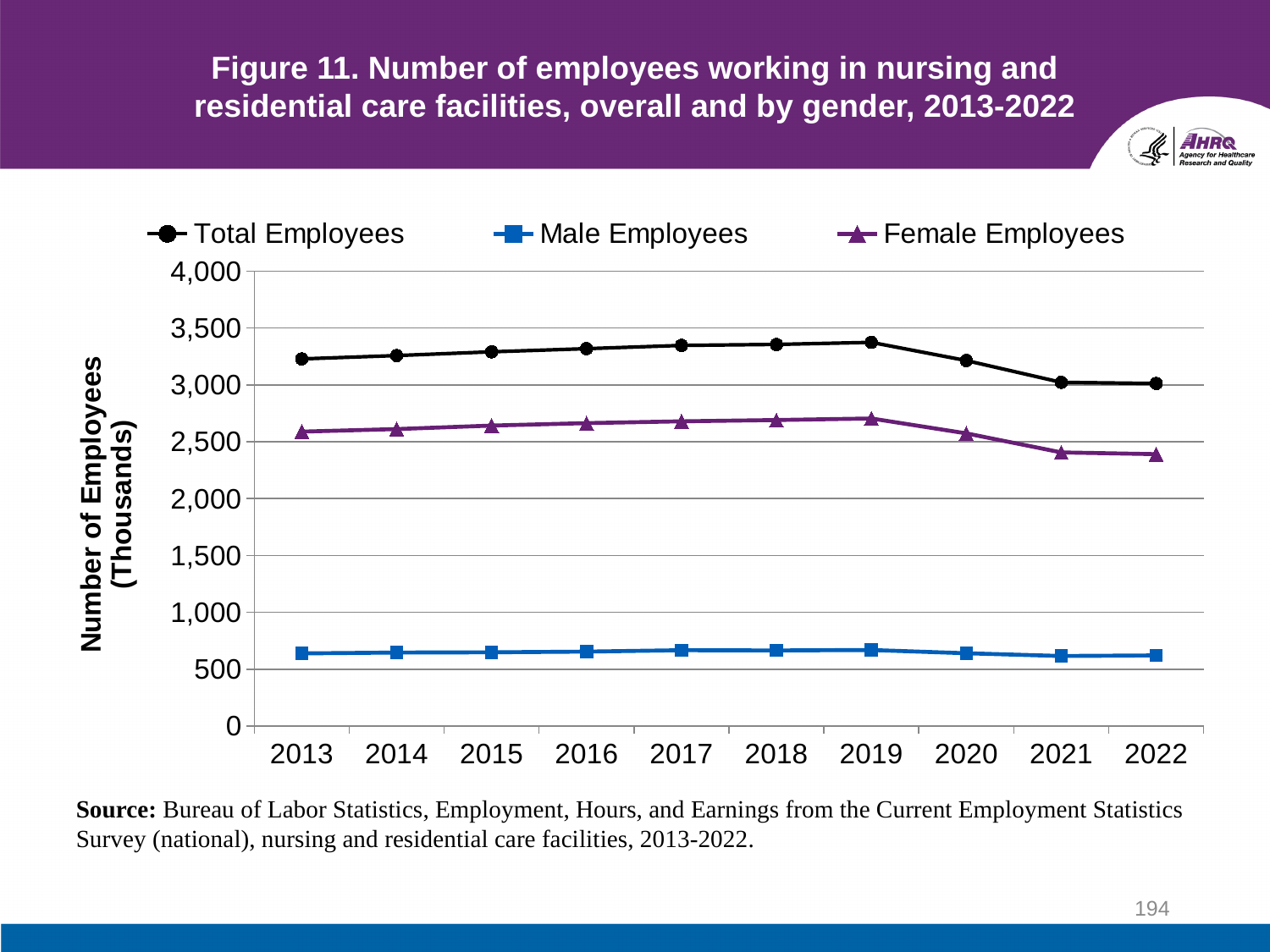
What is the label of the y axis? Number of Employees (Thousands) Which is larger for Total Employees, the value in 2019 or the value in 2022? 2019 Is the value for Total Employees in 2013 greater or less than 3,000? greater How many years are plotted along the x axis? 10 Do the values for Total Employees rise or fall from 2019 to 2022? fall What kind of chart is shown on the slide? line chart Which is larger in 2019, Female Employees or Male Employees? Female Employees How many series does the legend list? 3 Is the value for Male Employees in 2019 greater or less than 500? greater Is the value for Total Employees in 2019 greater or less than 3,500? less